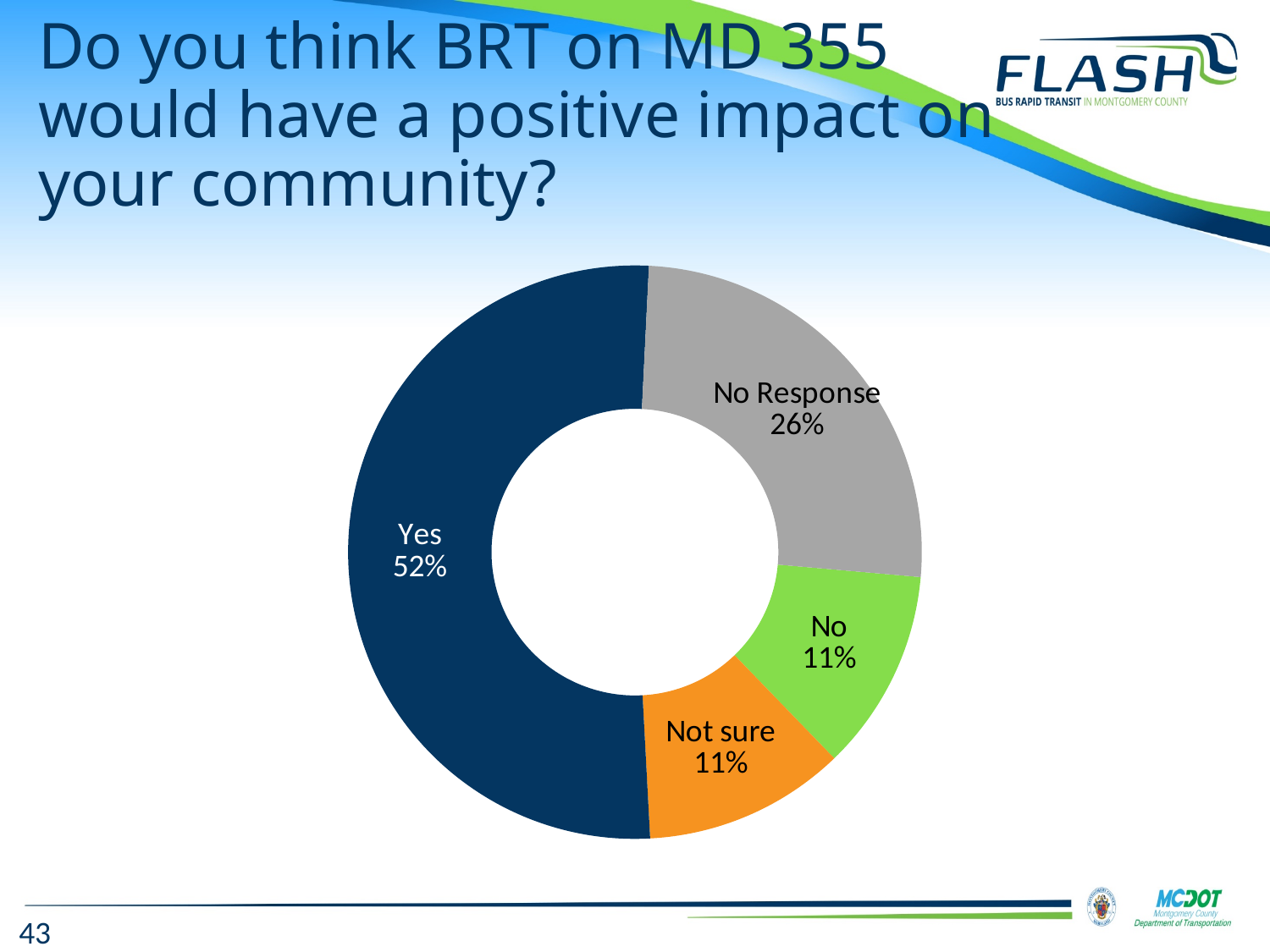
What is the combined share of No and Not sure? 22% What is the difference in percentage points between Yes and No Response? 26 How many response categories are shown in the chart? 4 What is the difference in percentage points between No Response and No? 15 Which response category has the largest share? Yes What percentage of respondents gave No Response? 26% What percentage of respondents answered Not sure? 11% What percentage of respondents answered Yes? 52% What kind of chart is shown on the slide? Doughnut (pie) chart Which is larger, the share for Yes or the share for No Response? Yes What colour is the Yes segment of the chart? Dark blue What percentage of respondents answered No? 11%